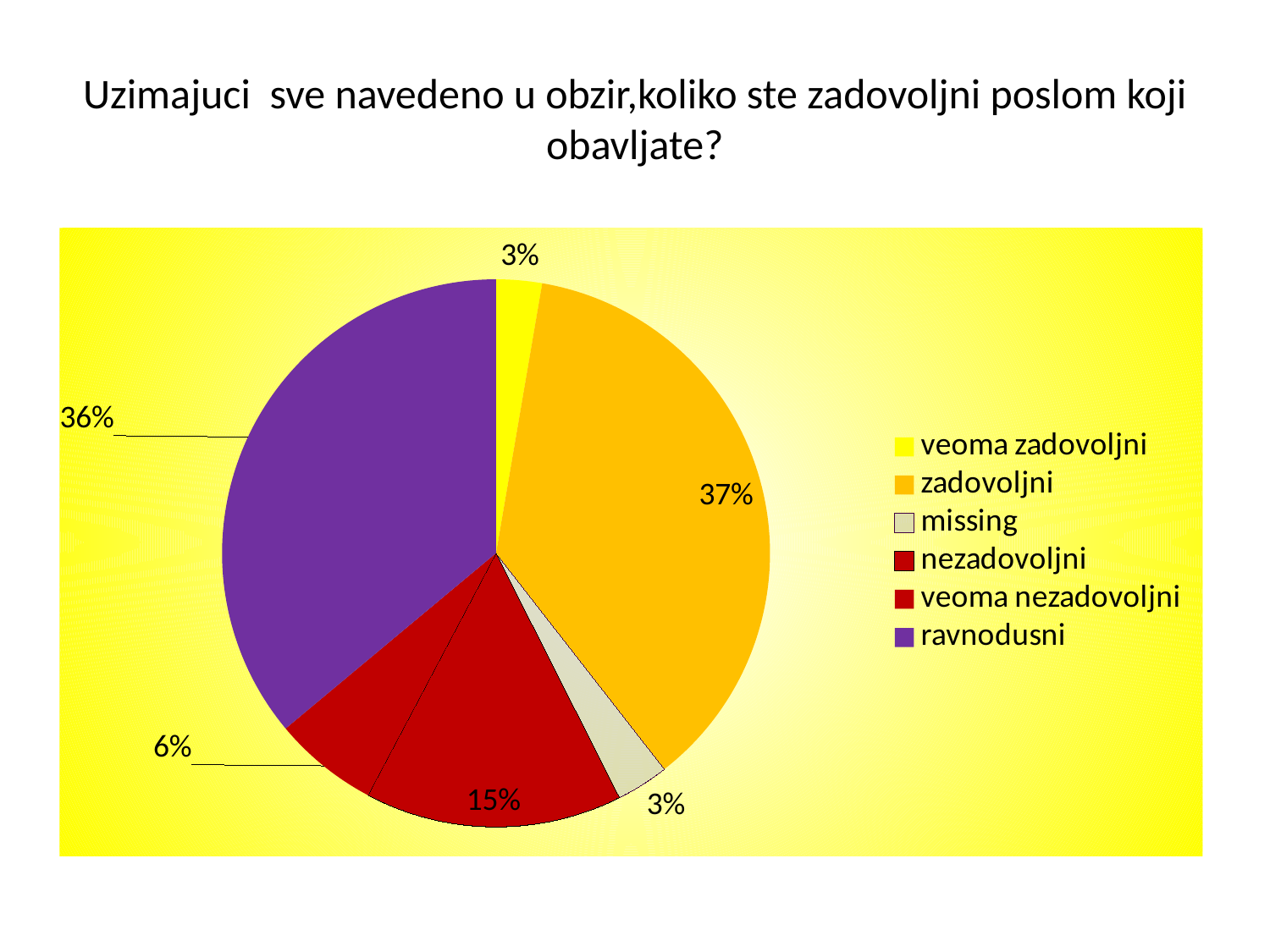
How many categories does the legend list? 6 What percentage is shown for 'veoma nezadovoljni'? 6% Which is larger, the slice for 'ravnodusni' or the slice for 'nezadovoljni'? ravnodusni What kind of chart is shown on the slide? pie chart What share of the pie does the 'zadovoljni' slice represent? 37% What percentage is shown for 'veoma zadovoljni'? 3% What colour is the 'ravnodusni' slice? purple What percentage is shown for 'ravnodusni'? 36% What percentage is shown for 'missing'? 3% What is the difference in percentage points between 'nezadovoljni' and 'veoma nezadovoljni'? 9 Which category has the largest slice of the pie? zadovoljni What percentage is shown for 'nezadovoljni'? 15%